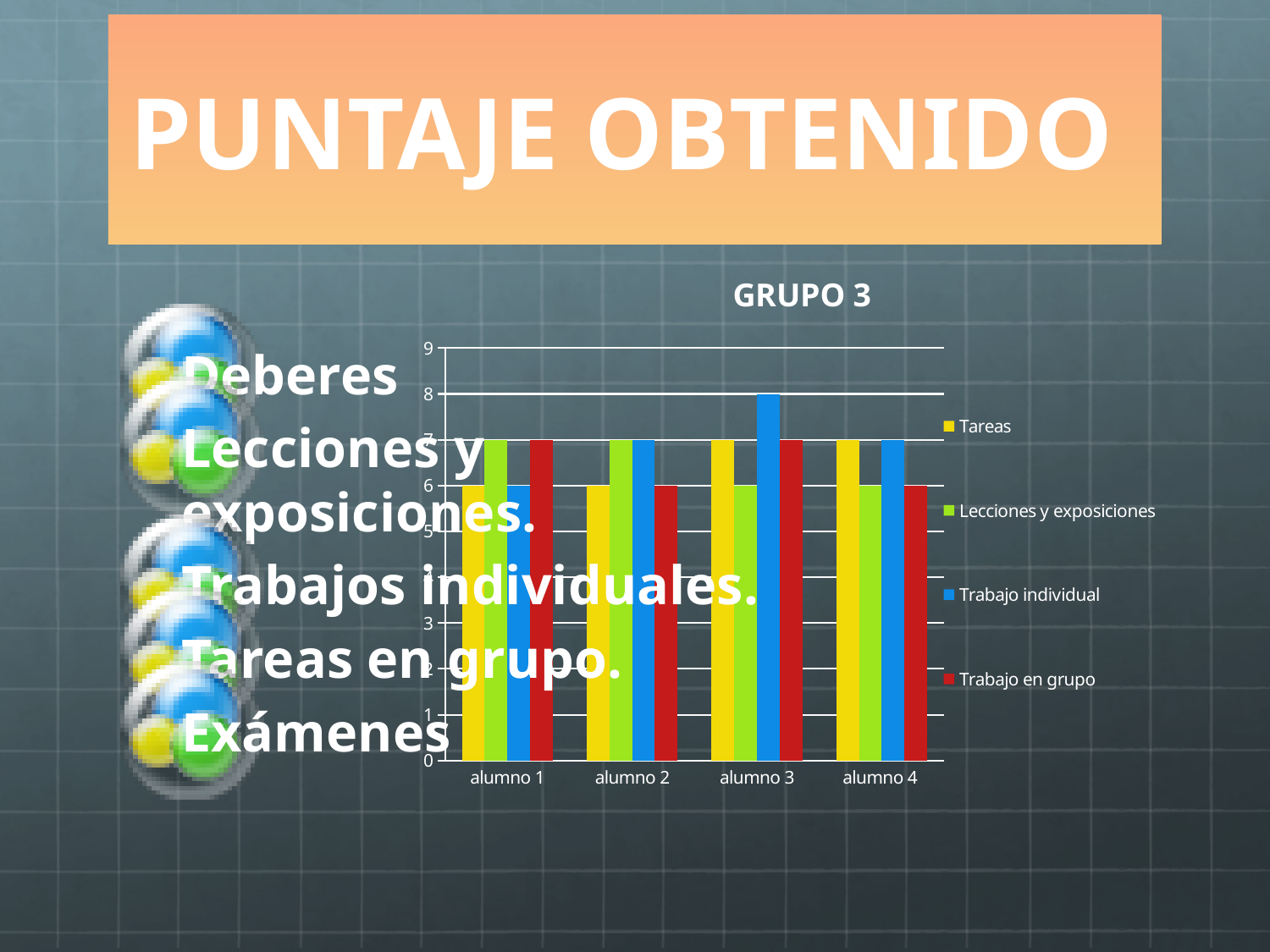
Is the Trabajo individual value for alumno 3 greater or less than 7? greater What is the Tareas value for alumno 1? 6 For alumno 2, which is larger: Tareas or Trabajo individual? Trabajo individual What is the Lecciones y exposiciones value for alumno 2? 7 What is the Trabajo en grupo value for alumno 4? 6 What type of chart is shown under the title GRUPO 3? bar chart What is the difference between the Trabajo individual value for alumno 3 and the Trabajo individual value for alumno 1? 2 Which colour represents the Trabajo en grupo series in the GRUPO 3 chart? red What is the Trabajo individual value for alumno 3? 8 Which student has the highest Trabajo individual value? alumno 3 How many students (categories) are shown on the x axis of the GRUPO 3 chart? 4 How many series does the legend of the GRUPO 3 chart list? 4